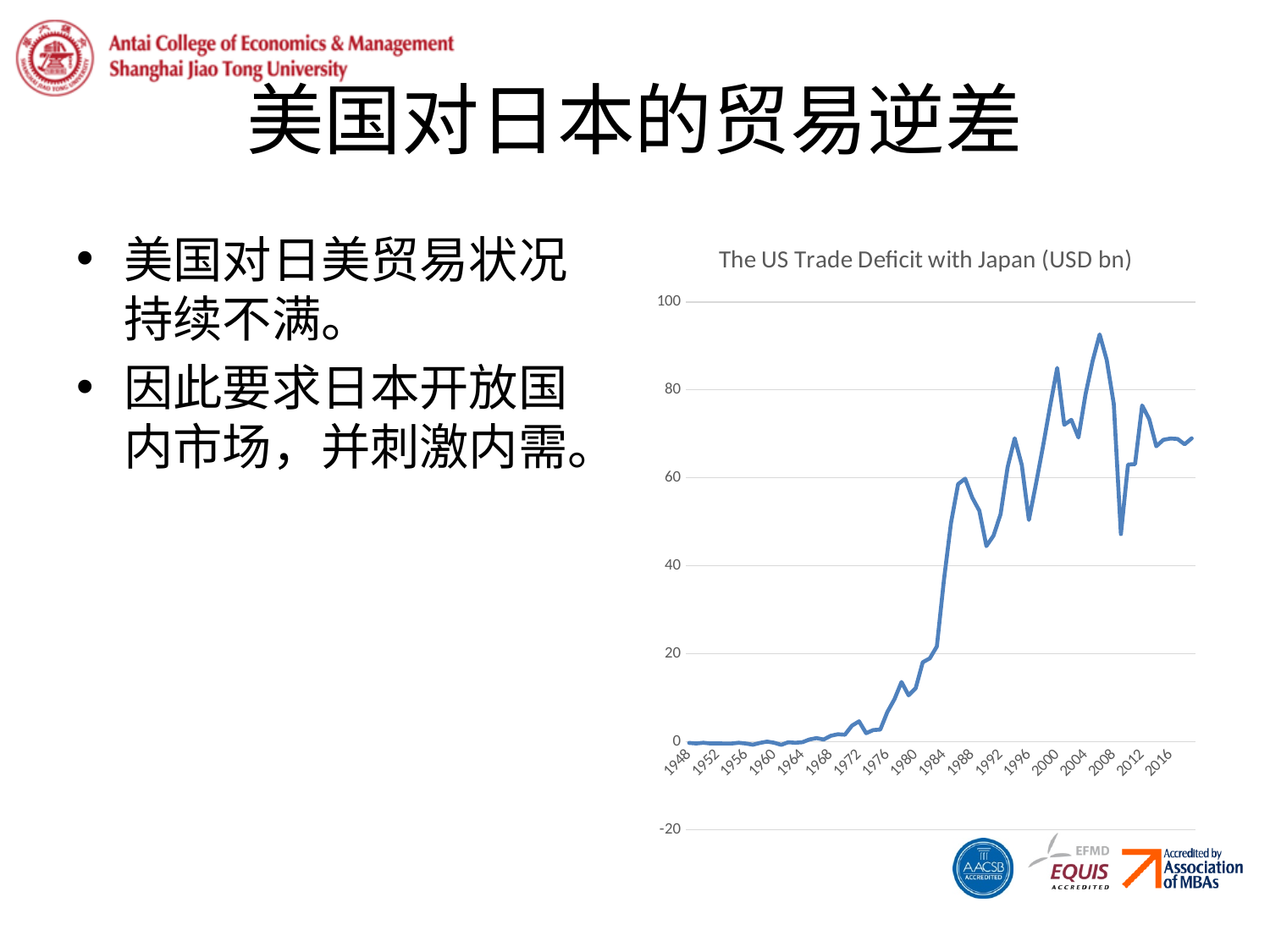
What kind of chart is shown on the slide? line chart Is the value for 2000 greater or less than 80? greater Is the value for 1976 greater or less than 20? less How many lines are plotted on the chart? 1 What is the highest value labelled on the y axis? 100 What is the title of the chart? The US Trade Deficit with Japan (USD bn) Is the value for 2016 greater or less than 60? greater How many year labels are shown on the x axis? 18 Overall, does the US trade deficit with Japan rise or fall from 1948 to 2016? rise